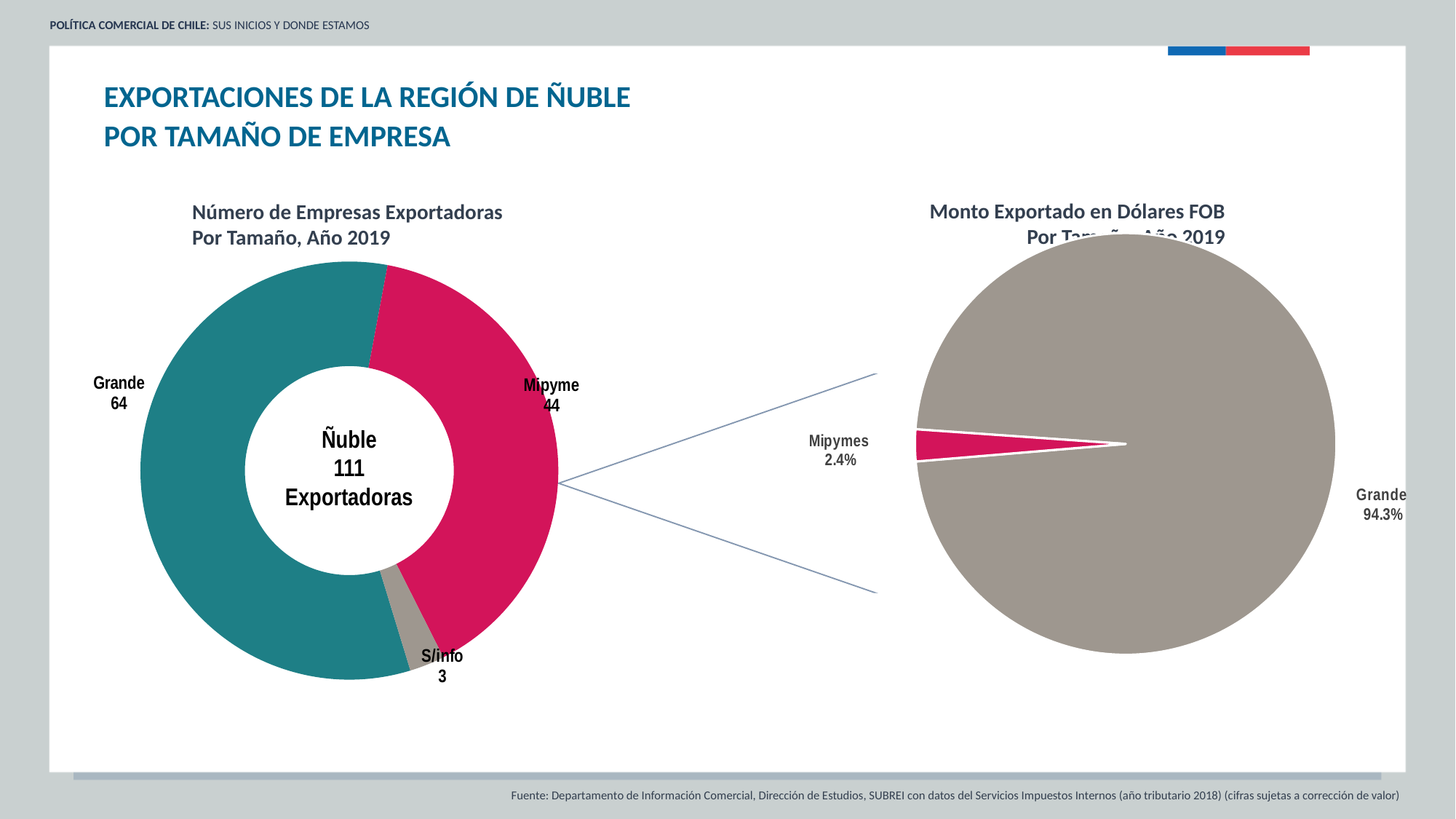
In the 'Número de Empresas Exportadoras' chart, what total number of exporters is shown in the centre of the donut? 111 What type of chart is the 'Monto Exportado en Dólares FOB' chart on the right? Pie chart In the 'Monto Exportado en Dólares FOB' chart, which is larger, the Grande share or the Mipymes share? Grande In the 'Número de Empresas Exportadoras' chart, which category has the most exporting companies? Grande How many categories are shown in the 'Número de Empresas Exportadoras' chart? 3 In the 'Número de Empresas Exportadoras' chart, how many exporting companies are in the Grande category? 64 In the 'Número de Empresas Exportadoras' chart, which category has the fewest exporting companies? S/info In the 'Monto Exportado en Dólares FOB' chart, what share of the exported amount corresponds to Mipymes? 2.4% In the 'Número de Empresas Exportadoras' chart, how many exporting companies are in the Mipyme category? 44 In the 'Número de Empresas Exportadoras' chart, what is the difference between the Grande and Mipyme values? 20 In the 'Monto Exportado en Dólares FOB' chart, what share of the exported amount corresponds to Grande? 94.3% In the 'Número de Empresas Exportadoras' chart, what is the value for S/info? 3